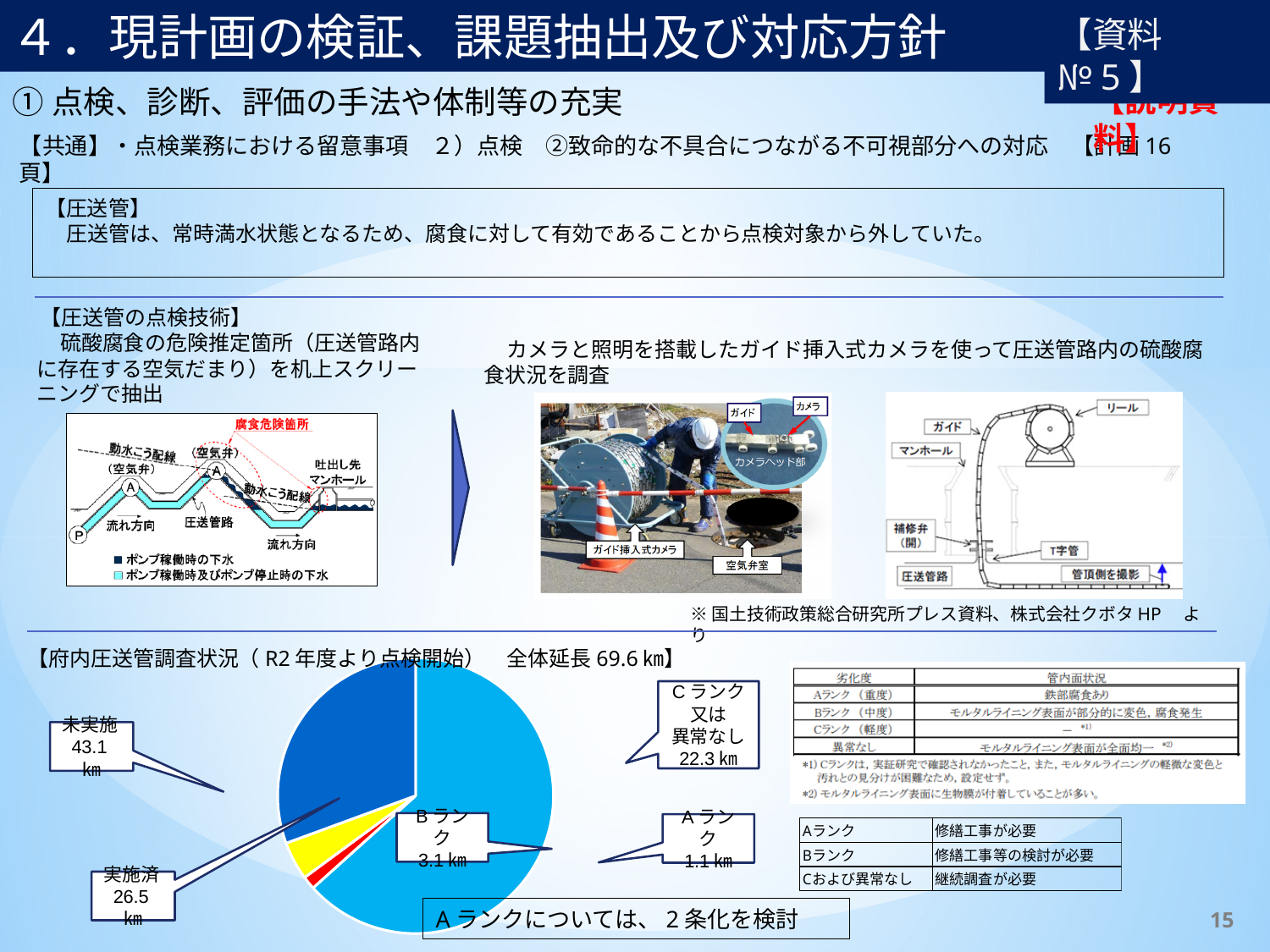
In the pie chart, what is the length for Bランク? 3.1 km Which rank has the smallest slice in the pie chart? Aランク In the pie chart, which is larger, Bランク or Aランク? Bランク What is the difference between 未実施 and 実施済 in the pie chart? 16.6 km Which category has the largest slice in the pie chart? 未実施 In the pie chart, what is the length for 未実施? 43.1 km What is the combined length of Cランク又は異常なし, Bランク and Aランク in the pie chart? 26.5 km In the pie chart, what is the length for 実施済? 26.5 km In the pie chart, what is the length for Cランク又は異常なし? 22.3 km In the pie chart, what is the length for Aランク? 1.1 km What kind of chart is used to show the 府内圧送管調査状況? pie chart What colour is the Aランク slice in the pie chart? red